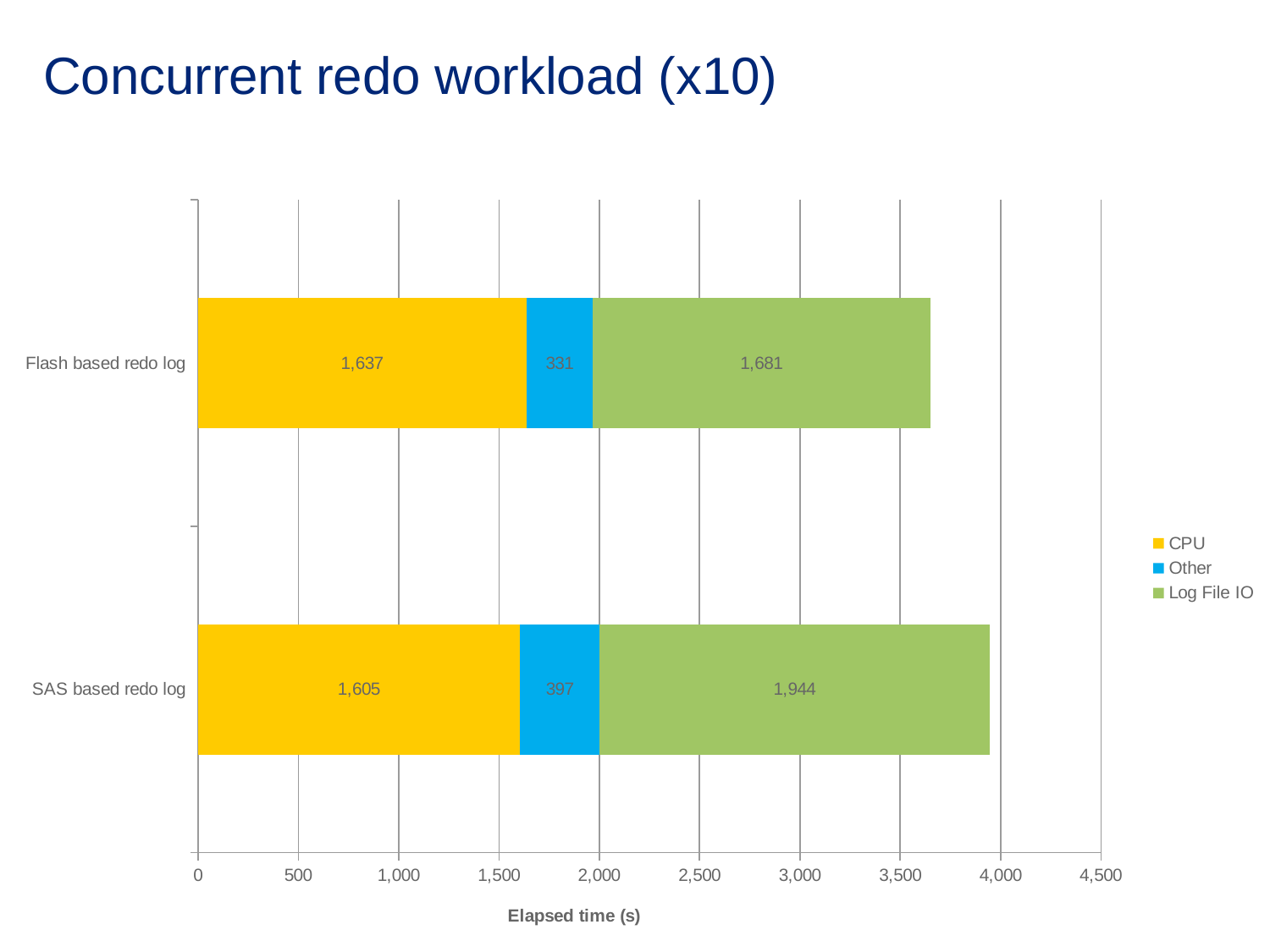
What is the Log File IO value for SAS based redo log? 1,944 How many series does the legend list? 3 What type of chart is shown on the slide? Stacked bar chart Is the CPU value for Flash based redo log larger than the CPU value for SAS based redo log? Yes What is the total elapsed time for the Flash based redo log bar? 3,649 Which category has the lower Other value? Flash based redo log How many categories are shown on the chart? 2 What is the CPU value for Flash based redo log? 1,637 What is the total elapsed time for the SAS based redo log bar? 3,946 What is the difference in Log File IO between SAS based redo log and Flash based redo log? 263 What is the Other value for Flash based redo log? 331 Which category has the higher Log File IO value? SAS based redo log